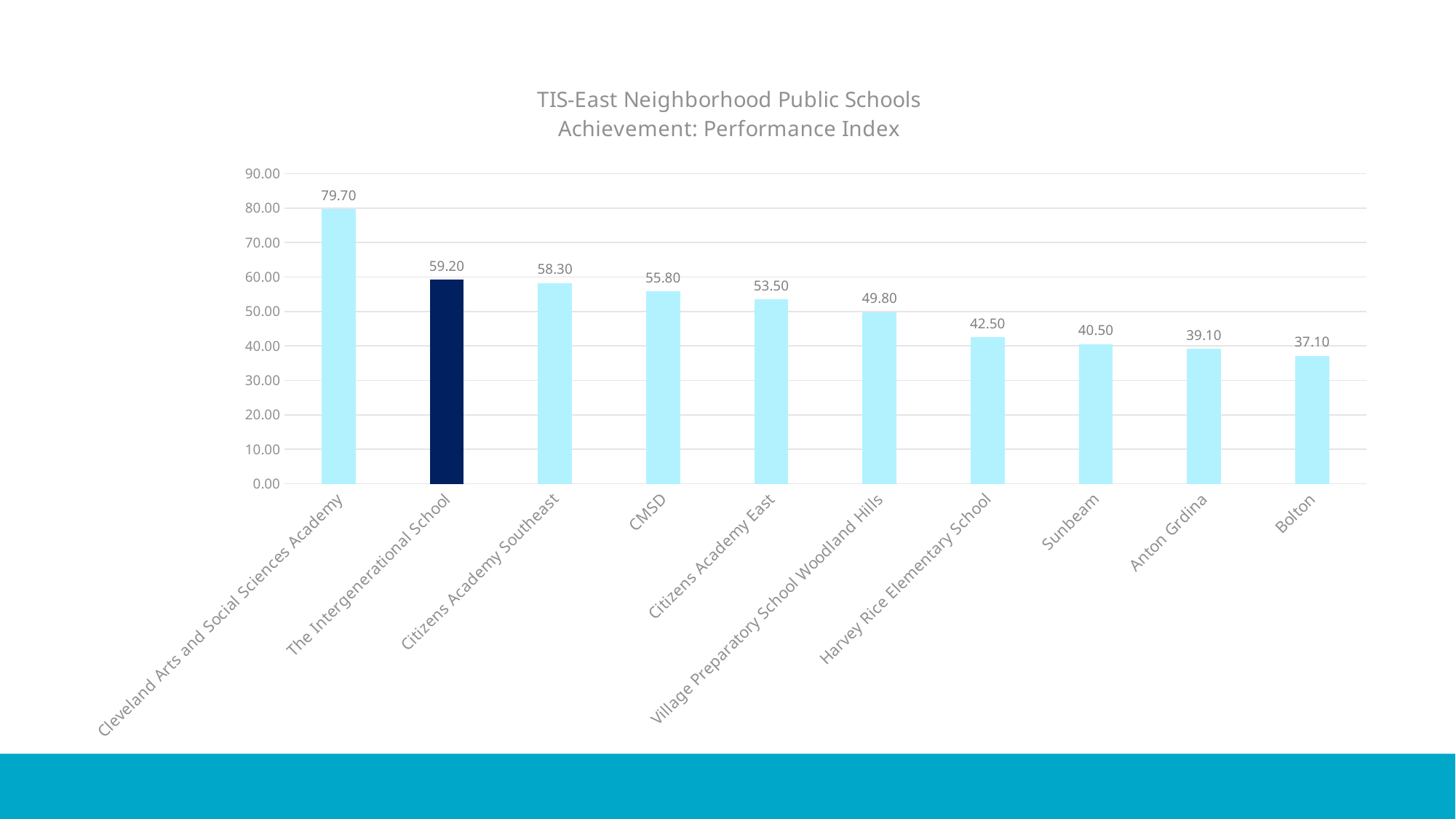
What is the difference between the Performance Index of Cleveland Arts and Social Sciences Academy and The Intergenerational School? 20.50 Which school has the lowest Performance Index? Bolton What is the Performance Index value for Sunbeam? 40.50 What is the difference between the Performance Index of Citizens Academy East and Village Preparatory School Woodland Hills? 3.70 What is the Performance Index value for The Intergenerational School? 59.20 Which bar is shown in a dark navy colour, different from the others? The Intergenerational School Which has a higher Performance Index, Harvey Rice Elementary School or Anton Grdina? Harvey Rice Elementary School What is the Performance Index value for CMSD? 55.80 What kind of chart is shown on the slide? Bar chart How many schools are shown in the chart? 10 Which school has the highest Performance Index? Cleveland Arts and Social Sciences Academy Is the Performance Index for Citizens Academy Southeast greater or less than 50.00? greater